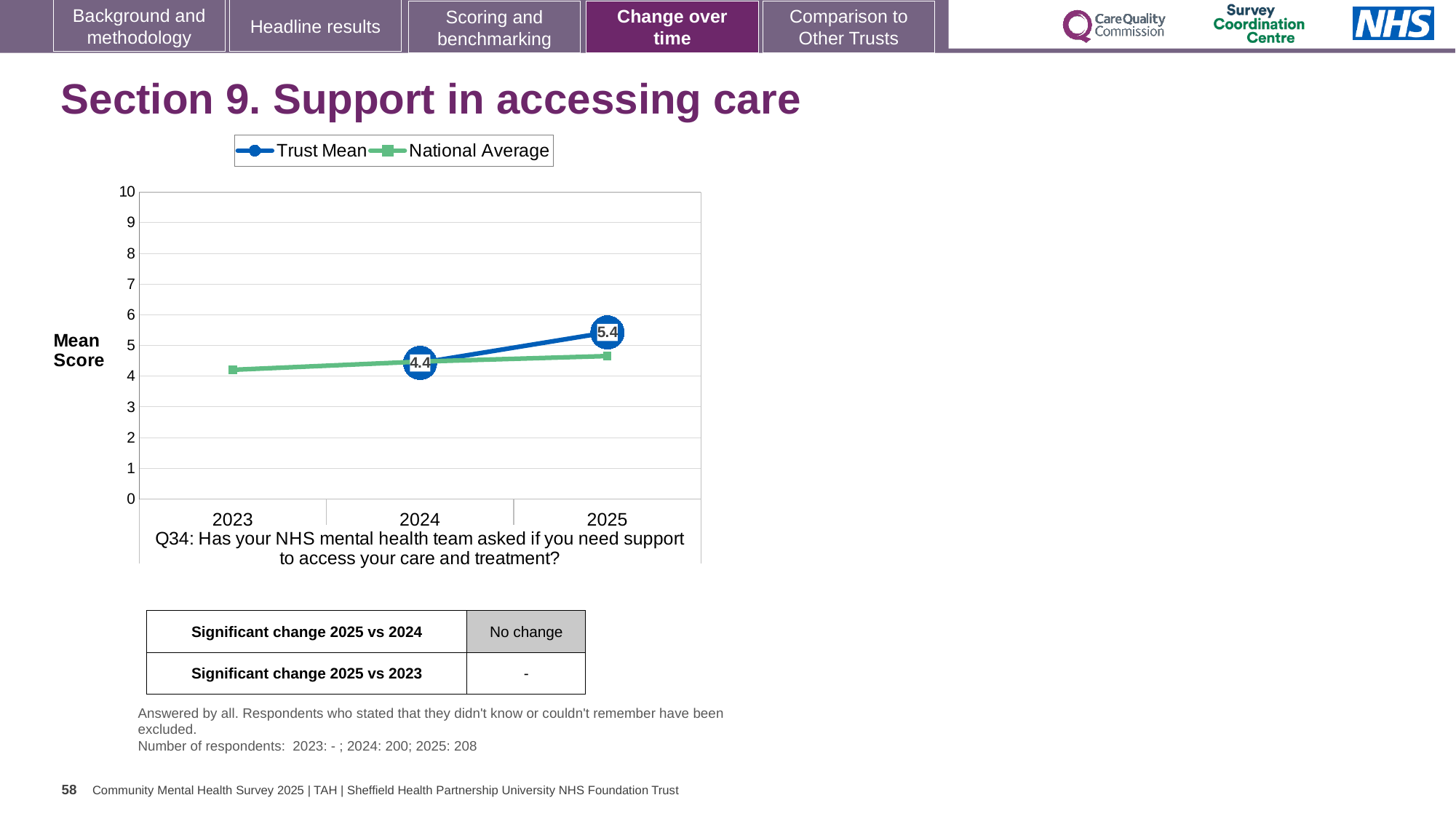
How many years are shown on the x axis? 3 How many series does the legend list? 2 Is the National Average value for 2025 greater or less than 5? less What is the Trust Mean score for 2024? 4.4 By how much did the Trust Mean score increase from 2024 to 2025? 1.0 What is the Trust Mean score for 2025? 5.4 What kind of chart is shown on the slide? line chart What is the label on the y axis of the chart? Mean Score In 2025, which is higher: the Trust Mean or the National Average? Trust Mean Does the Trust Mean rise or fall from 2024 to 2025? rise Is the National Average value for 2023 greater or less than 5? less In which year is the Trust Mean score highest? 2025